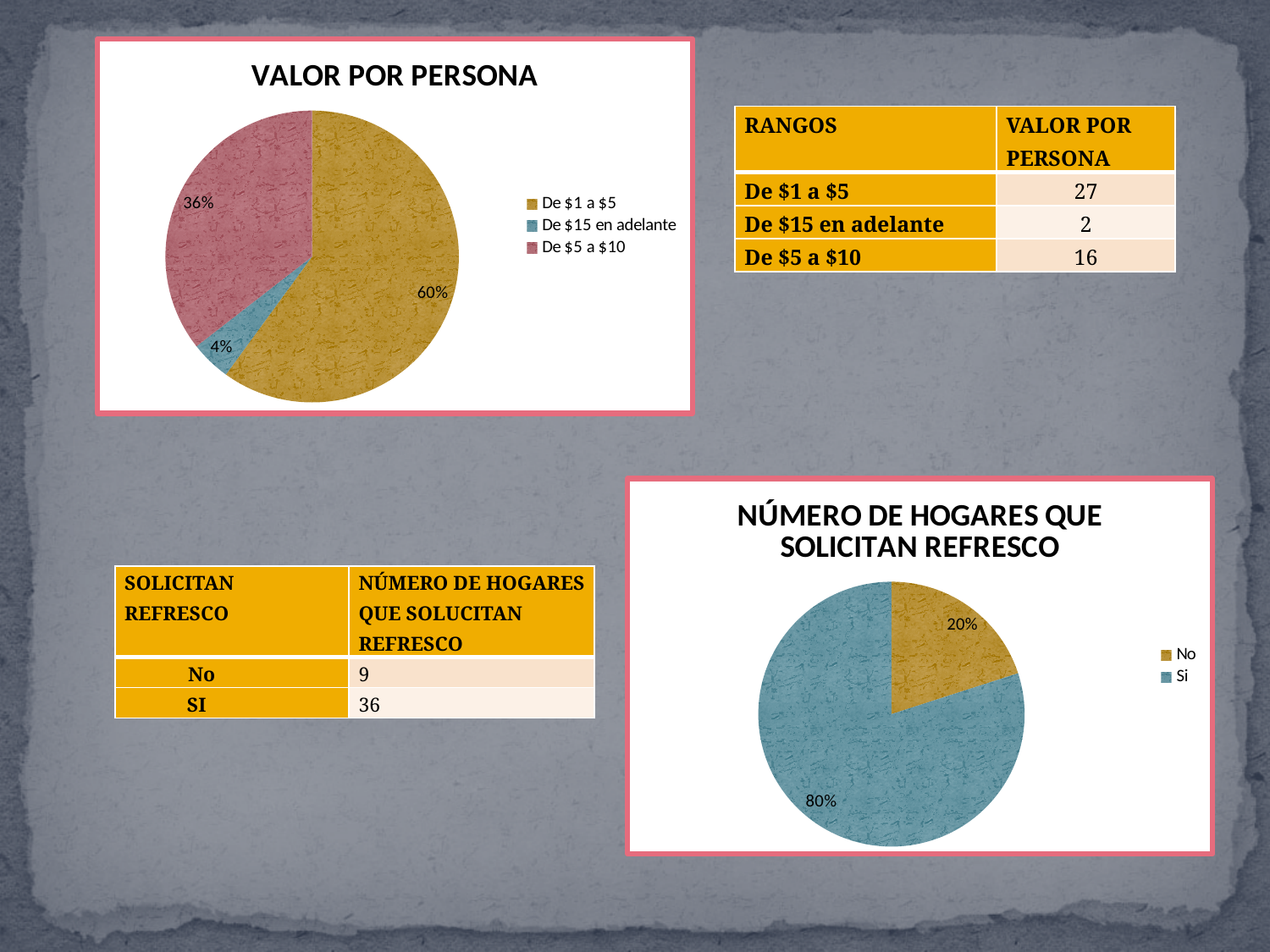
In the "VALOR POR PERSONA" chart, what is the difference in percentage points between "De $1 a $5" and "De $5 a $10"? 24 In the "VALOR POR PERSONA" chart, how many categories does the legend list? 3 In the "NÚMERO DE HOGARES QUE SOLICITAN REFRESCO" chart, what colour is the "No" slice? Gold/yellow In the "NÚMERO DE HOGARES QUE SOLICITAN REFRESCO" chart, which slice is larger, "Si" or "No"? Si In the "VALOR POR PERSONA" chart, which category has the largest slice? De $1 a $5 In the "NÚMERO DE HOGARES QUE SOLICITAN REFRESCO" chart, what share of the pie does "No" take? 20% What kind of chart is the "VALOR POR PERSONA" chart? Pie chart In the "VALOR POR PERSONA" chart, which category has the smallest slice? De $15 en adelante In the "NÚMERO DE HOGARES QUE SOLICITAN REFRESCO" chart, what share of the pie does "Si" take? 80% In the "VALOR POR PERSONA" chart, what share of the pie does "De $5 a $10" take? 36%